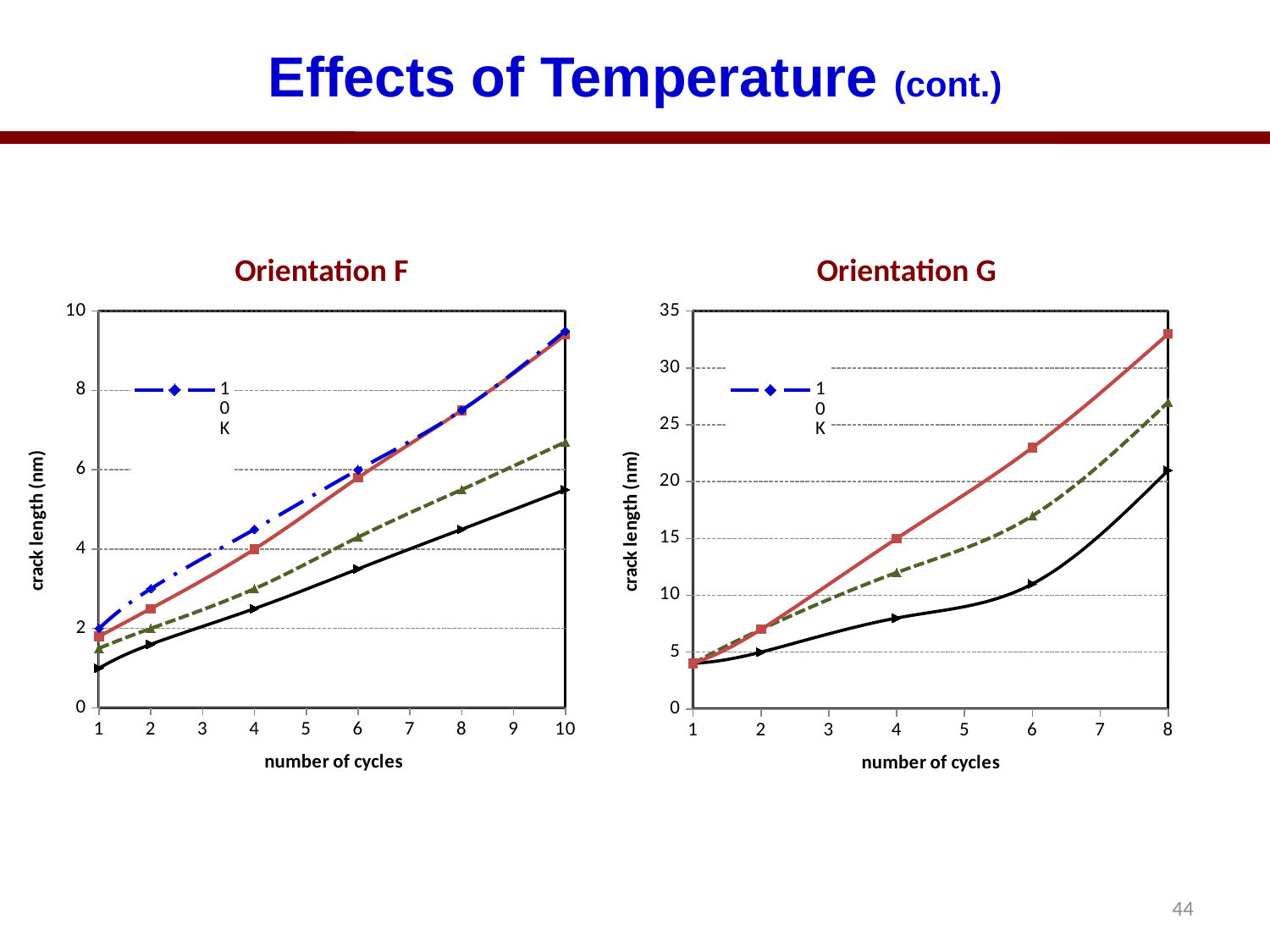
In the Orientation F chart, does crack length rise or fall as the number of cycles increases? rise In the Orientation F chart, is the value of the black solid line at 10 cycles greater or less than 6? less In the Orientation G chart, is the value of the black solid line at 8 cycles greater or less than 25? less In the Orientation F chart, is the value of the blue dash-dot line at 10 cycles greater or less than 8? greater In the Orientation G chart, what is the x-axis title? number of cycles In the Orientation G chart, does crack length rise or fall as the number of cycles increases? rise In the Orientation G chart, which line reaches the highest crack length at 8 cycles? the red solid line In the Orientation F chart, what is the y-axis title? crack length (nm) In the Orientation F chart, at 10 cycles, which is higher: the red solid line or the black solid line? the red solid line What kind of chart is the Orientation F chart? line chart What kind of chart is the Orientation G chart? line chart